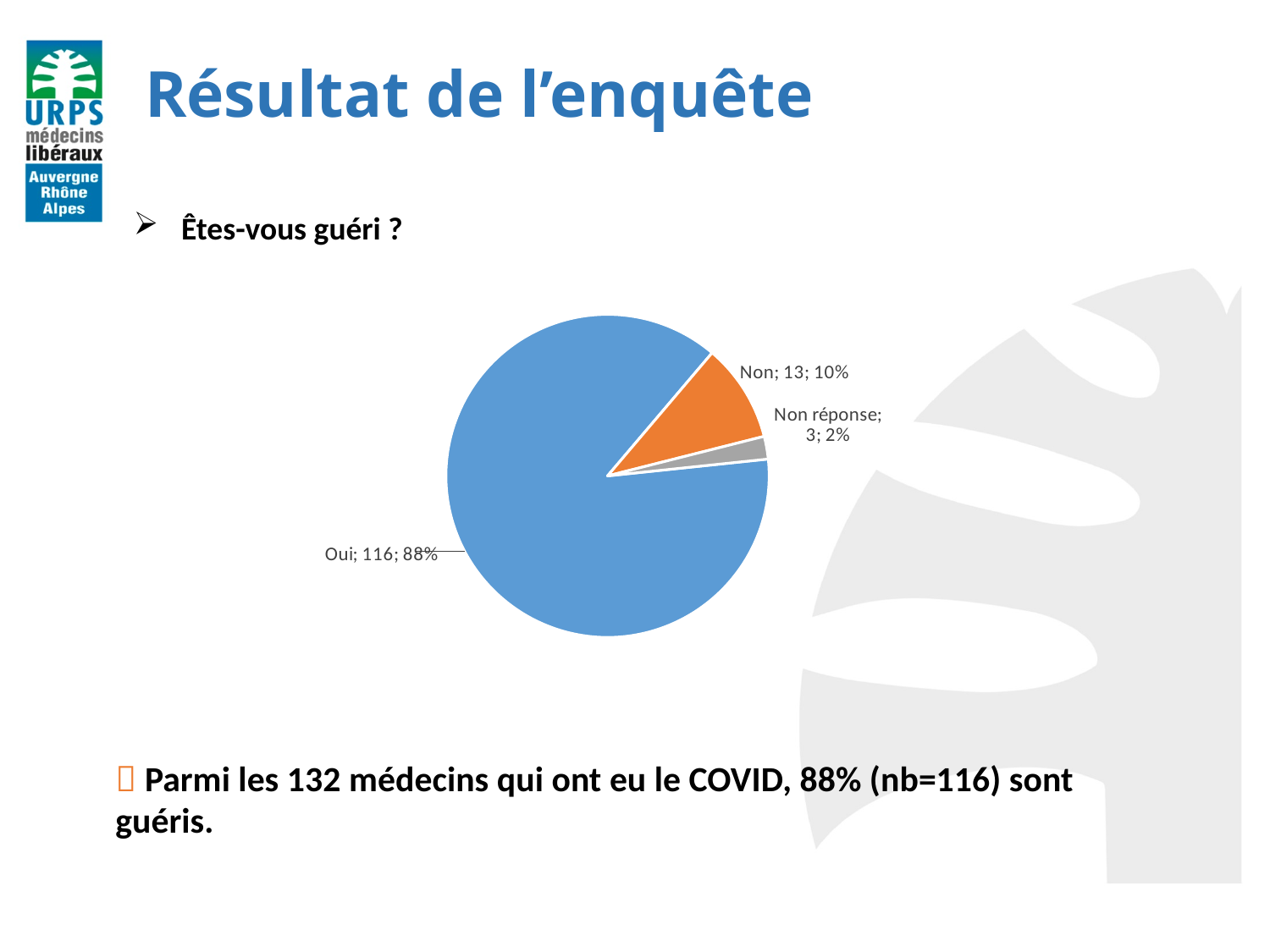
What percentage share does the "Non" slice represent? 10% Which slice has a larger count, "Non" or "Non réponse"? Non What is the count for the "Non réponse" slice? 3 What percentage share does the "Oui" slice represent? 88% What colour is the "Oui" slice? blue What is the count for the "Oui" slice? 116 How many slices does the pie chart have? 3 What kind of chart is shown on the slide? pie chart What is the total count across all three slices? 132 What is the difference in count between the "Non" and "Non réponse" slices? 10 Which slice is the smallest? Non réponse Which slice is the largest? Oui